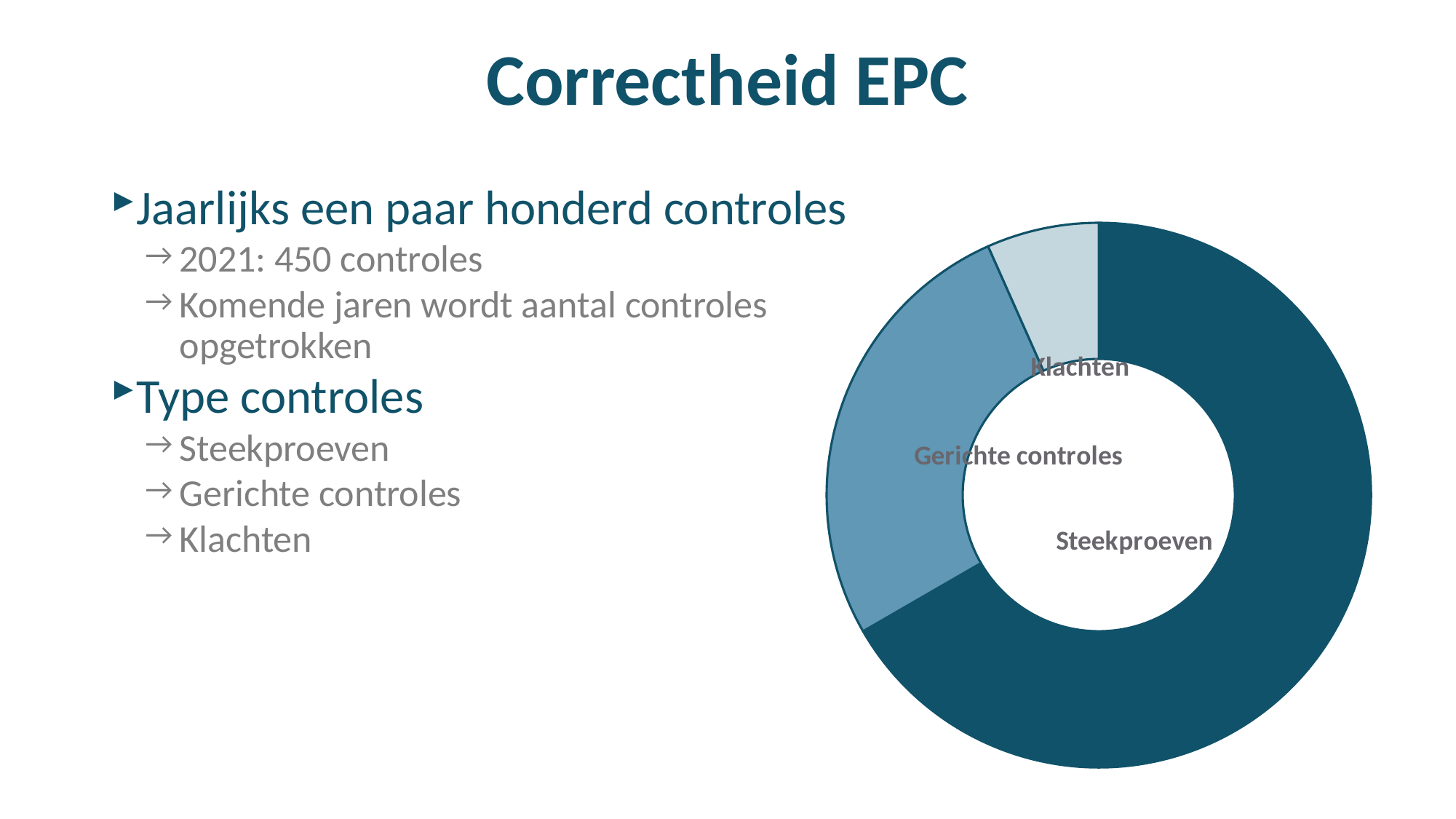
Which category is shown in the lightest colour in the doughnut chart? Klachten Which category has the largest slice in the doughnut chart? Steekproeven Which category has the smallest slice in the doughnut chart? Klachten Does the Steekproeven slice take up more or less than half of the doughnut chart? more What kind of chart is shown on the slide? doughnut chart How many categories (slices) does the doughnut chart show? 3 What are the three categories labelled in the doughnut chart? Steekproeven, Gerichte controles, Klachten Which slice is larger in the doughnut chart, Steekproeven or Gerichte controles? Steekproeven Which slice is larger in the doughnut chart, Gerichte controles or Klachten? Gerichte controles